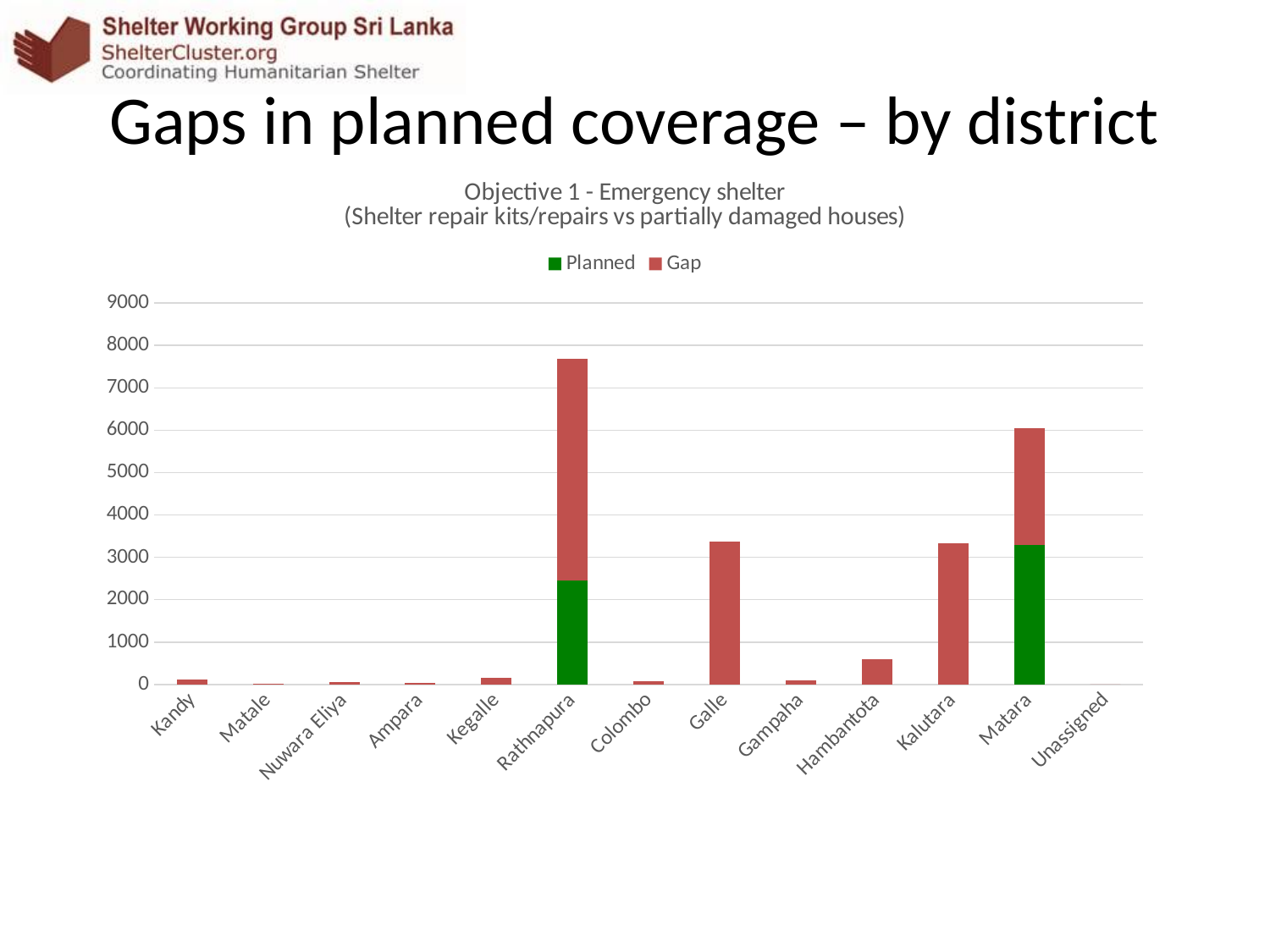
Is the total bar for Galle greater or less than 3000? greater Is the total bar for Matara greater or less than 5000? greater How many districts (categories) are shown on the x axis? 13 Is the total bar for Hambantota greater or less than 1000? less Which district has the tallest bar overall? Rathnapura Which colour represents the Gap series in the legend? Red Which district has the larger Planned (green) segment, Matara or Rathnapura? Matara Which has the larger total bar, Rathnapura or Matara? Rathnapura How many series does the legend list? 2 What kind of chart is shown on the slide? Stacked bar chart